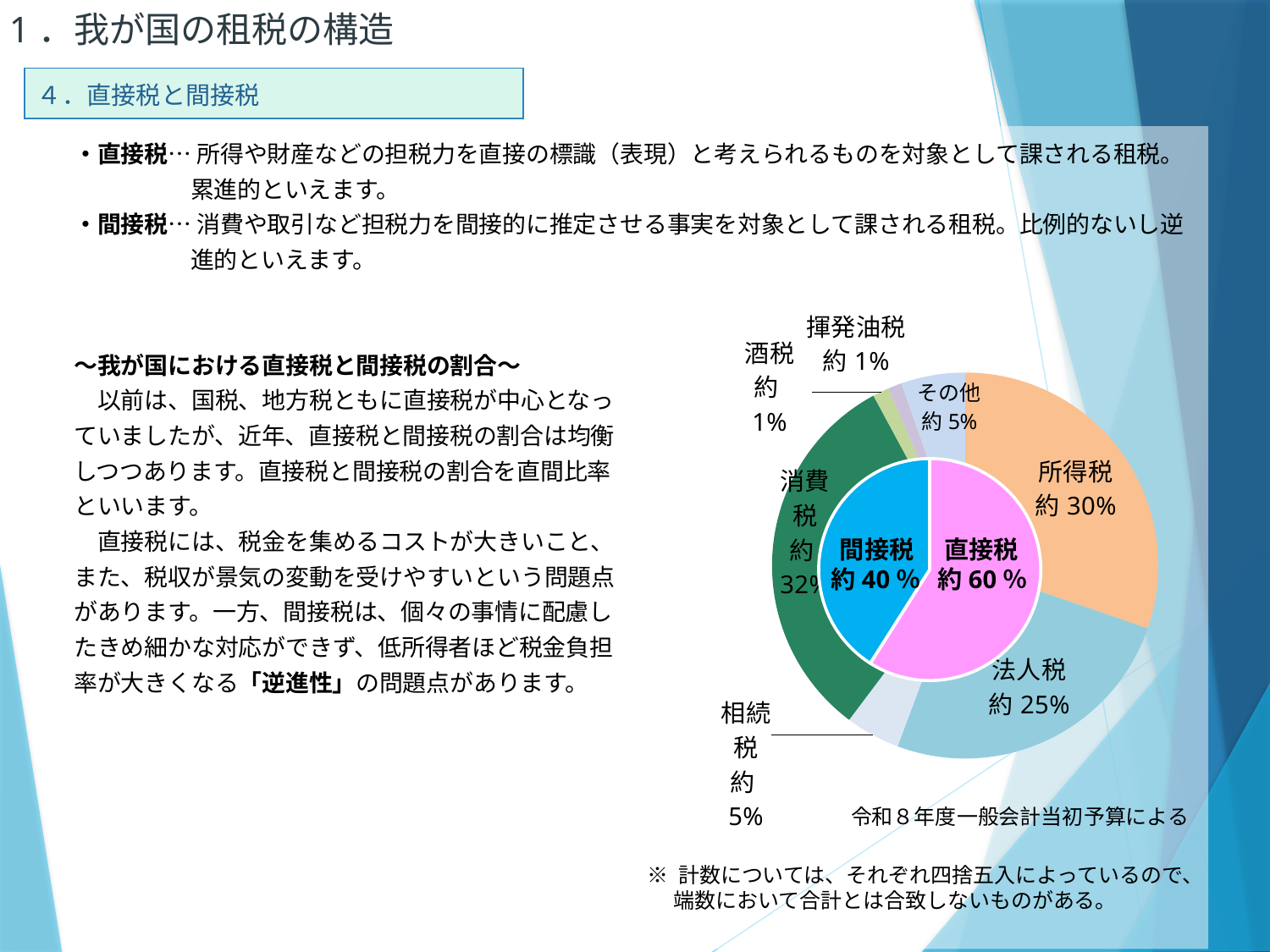
What share does 消費税 account for in the chart? 約 32% How many tax categories are labelled in the outer ring of the chart? 7 What share does 所得税 account for in the chart? 約 30% Which is larger in the chart, 直接税 or 間接税? 直接税 According to the note below the chart, which budget is the chart based on? 令和８年度一般会計当初予算 What share does 相続税 account for in the chart? 約 5% What share does 直接税 account for in the inner ring of the chart? 約 60% What share does 間接税 account for in the inner ring of the chart? 約 40% What kind of chart is shown on the slide? pie chart Which individual tax category in the outer ring has the largest share? 消費税 What share does 法人税 account for in the chart? 約 25% How many percentage points larger is 所得税 than 法人税 in the chart? 5